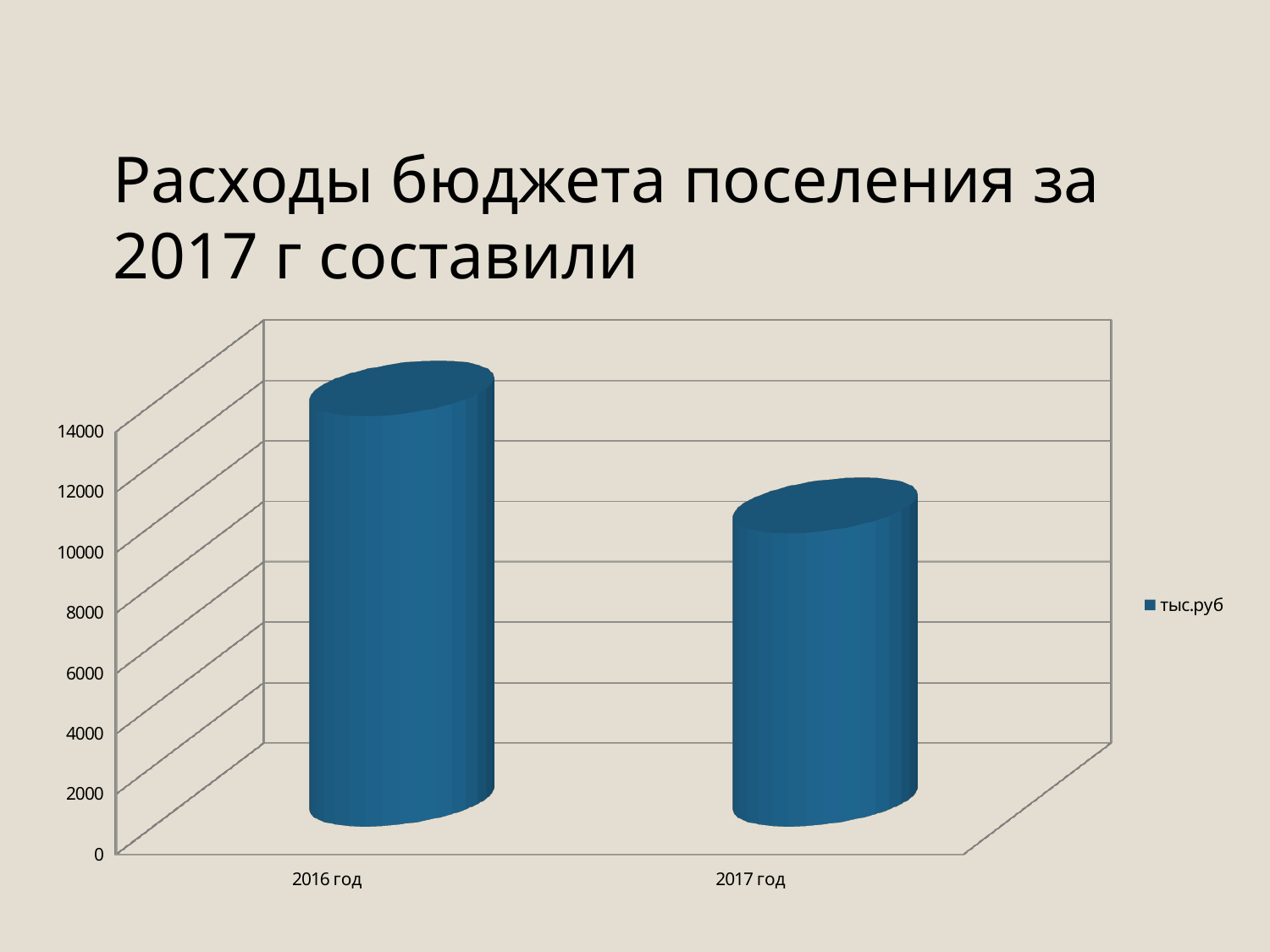
Which is larger, the value for 2016 год or the value for 2017 год? 2016 год Which year has the lowest value in the chart? 2017 год What kind of chart is shown on the slide? bar chart Is the value for 2017 год greater or less than 12000? less Which year has the highest value in the chart? 2016 год Is the value for 2016 год greater or less than 12000? greater What is the legend entry shown for the series in the chart? тыс.руб How many series does the legend list? 1 How many categories are shown on the x axis of the chart? 2 What is the title of the slide containing the chart? Расходы бюджета поселения за 2017 г составили Do the values rise or fall from 2016 год to 2017 год? fall Is the value for 2017 год greater or less than 8000? greater